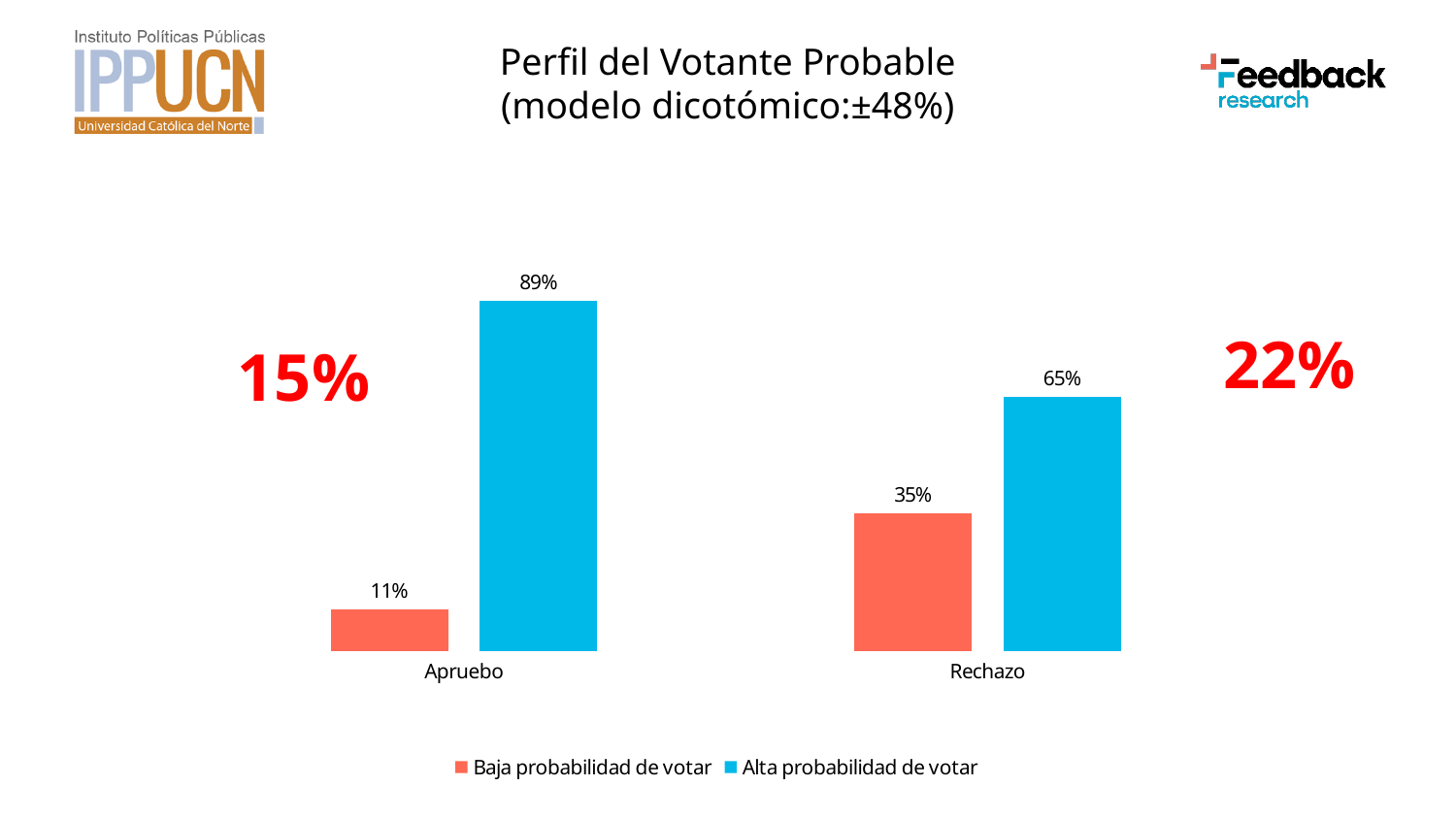
What is the value for 'Baja probabilidad de votar' in the Rechazo category? 35% What is the value for 'Baja probabilidad de votar' in the Apruebo category? 11% Which is larger: 'Baja probabilidad de votar' for Apruebo or for Rechazo? Rechazo Which bar has the highest value on the chart? Alta probabilidad de votar, Apruebo What is the value for 'Alta probabilidad de votar' in the Rechazo category? 65% What is the title of the chart? Perfil del Votante Probable (modelo dicotómico:±48%) How many series does the legend list? 2 Which bar has the lowest value on the chart? Baja probabilidad de votar, Apruebo What is the value for 'Alta probabilidad de votar' in the Apruebo category? 89% What kind of chart is shown on the slide? Bar chart How many categories are shown on the x axis? 2 What is the difference between the 'Alta probabilidad de votar' values for Apruebo and Rechazo? 24%